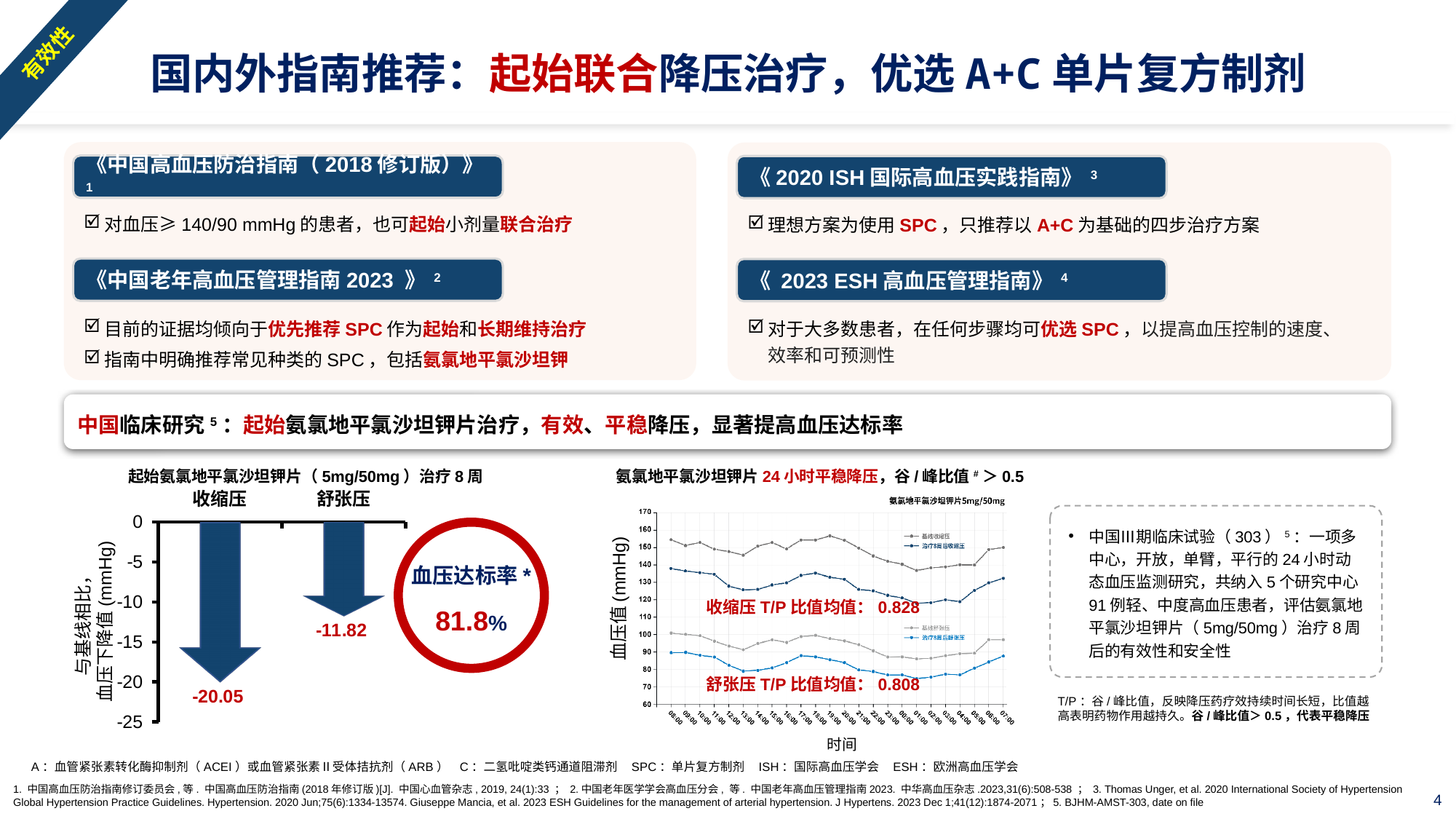
On the left bar chart, what is the difference between the 收缩压 and 舒张压 reduction values? 8.23 On the left bar chart, how many categories are plotted? 2 On the left bar chart, which category shows the larger reduction from baseline, 收缩压 or 舒张压? 收缩压 On the right line chart (氨氯地平氯沙坦钾片5mg/50mg), how many series does the legend list? 4 On the right line chart, is the value for 基线收缩压 at 18:00 greater or less than 150? greater On the left bar chart, what is the y-axis label? 与基线相比，血压下降值 (mmHg) On the right line chart (氨氯地平氯沙坦钾片5mg/50mg), what is the y-axis label? 血压值 (mmHg) On the right line chart, is the value for 治疗8周后舒张压 at 13:00 greater or less than 90? less On the left bar chart (起始氨氯地平氯沙坦钾片（5mg/50mg）治疗8周), what is the value for 收缩压? -20.05 What type of chart is the left chart showing 收缩压 and 舒张压 reductions? Bar chart On the right line chart, is the value for 治疗8周后收缩压 at 04:00 greater or less than 130? less On the left bar chart (起始氨氯地平氯沙坦钾片（5mg/50mg）治疗8周), what is the value for 舒张压? -11.82